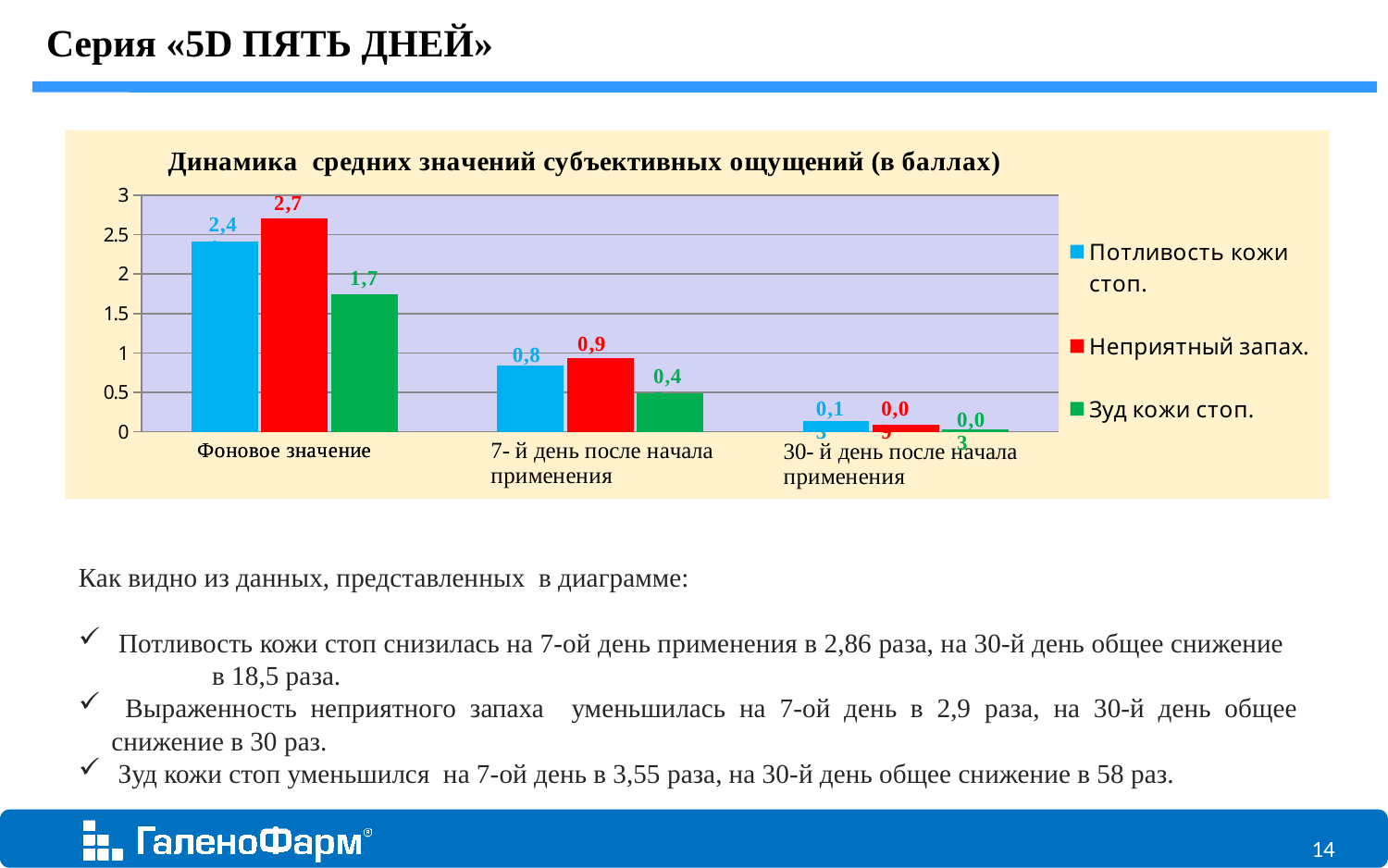
What is the value for Неприятный запах. at 7-й день после начала применения? 0,9 Which is larger at 7-й день после начала применения: Потливость кожи стоп. or Неприятный запах.? Неприятный запах. How many series does the legend list? 3 Do the values for Потливость кожи стоп. rise or fall from Фоновое значение to 30-й день после начала применения? Fall What is the difference between the Неприятный запах. value and the Зуд кожи стоп. value at Фоновое значение? 1,0 What is the value for Потливость кожи стоп. at 30-й день после начала применения? 0,1 Which series has the highest value at Фоновое значение? Неприятный запах. What kind of chart is shown on the slide? Bar chart What is the value for Потливость кожи стоп. at Фоновое значение? 2,4 Which series has the lowest value at 7-й день после начала применения? Зуд кожи стоп. How many categories are shown on the x axis? 3 What is the value for Зуд кожи стоп. at Фоновое значение? 1,7